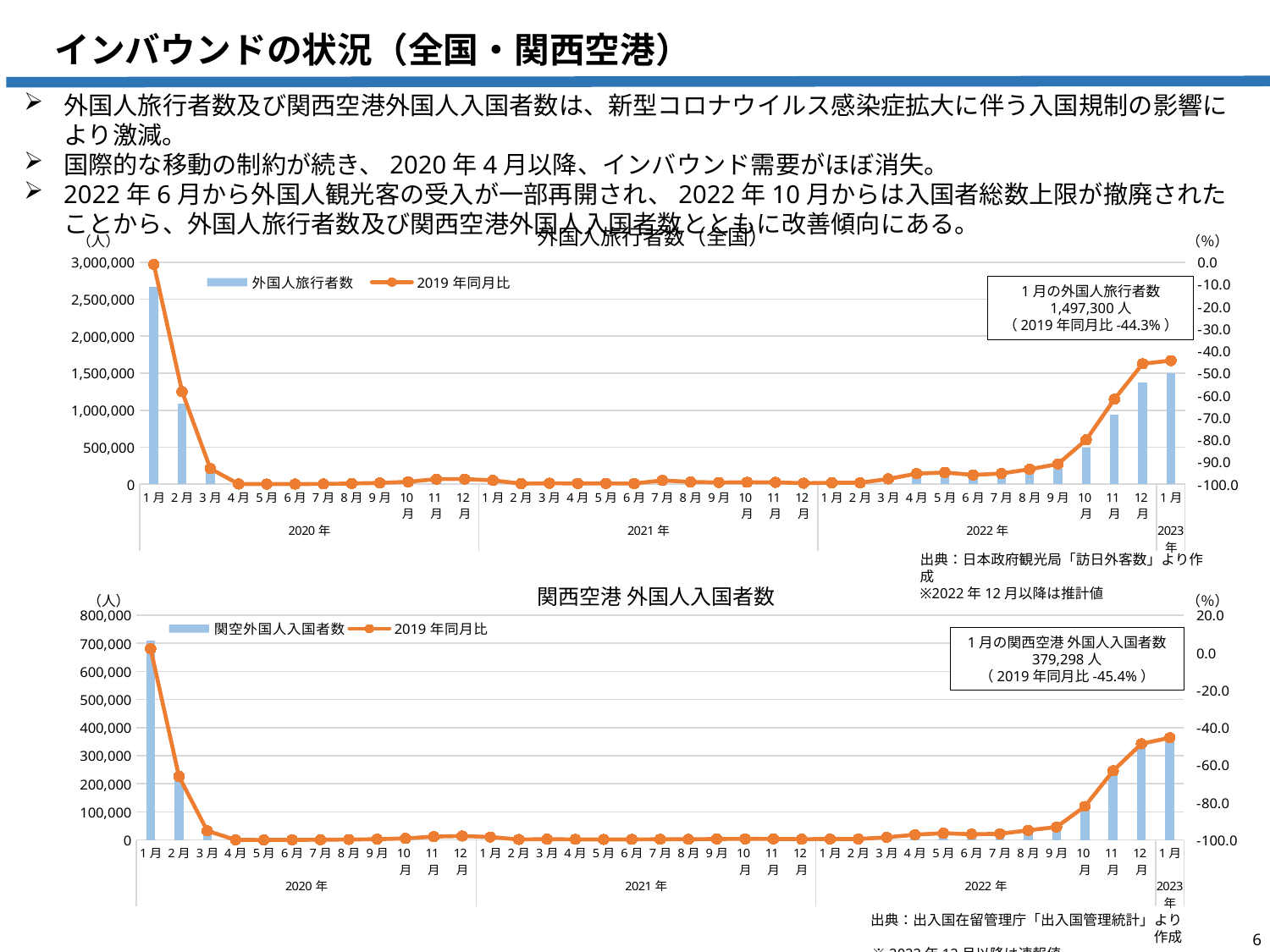
On the top chart (外国人旅行者数（全国）), which is larger, the bar for 2020年1月 or the bar for 2023年1月? 2020年1月 On the top chart (外国人旅行者数（全国）), what is the 2019年同月比 value for January 2023? -44.3% On the bottom chart (関西空港 外国人入国者数), what is the 2019年同月比 value for January 2023? -45.4% On the top chart (外国人旅行者数（全国）), what is the number of foreign travelers in January 2023 (2023年1月)? 1,497,300人 On the top chart (外国人旅行者数（全国）), do the bars rise or fall from 2022年10月 to 2023年1月? rise On the bottom chart (関西空港 外国人入国者数), which month has the highest bar? 2020年1月 On the top chart (外国人旅行者数（全国）), is the bar for 2022年12月 greater or less than 1,000,000? greater On the bottom chart (関西空港 外国人入国者数), is the bar for 2022年11月 greater or less than 300,000? less How many series does the legend of the bottom chart (関西空港 外国人入国者数) list? 2 On the top chart (外国人旅行者数（全国）), which month has the highest bar? 2020年1月 What kind of chart is the bottom chart (関西空港 外国人入国者数)? Combined bar and line chart On the bottom chart (関西空港 外国人入国者数), what is the number of foreign entrants at Kansai Airport in January 2023? 379,298人